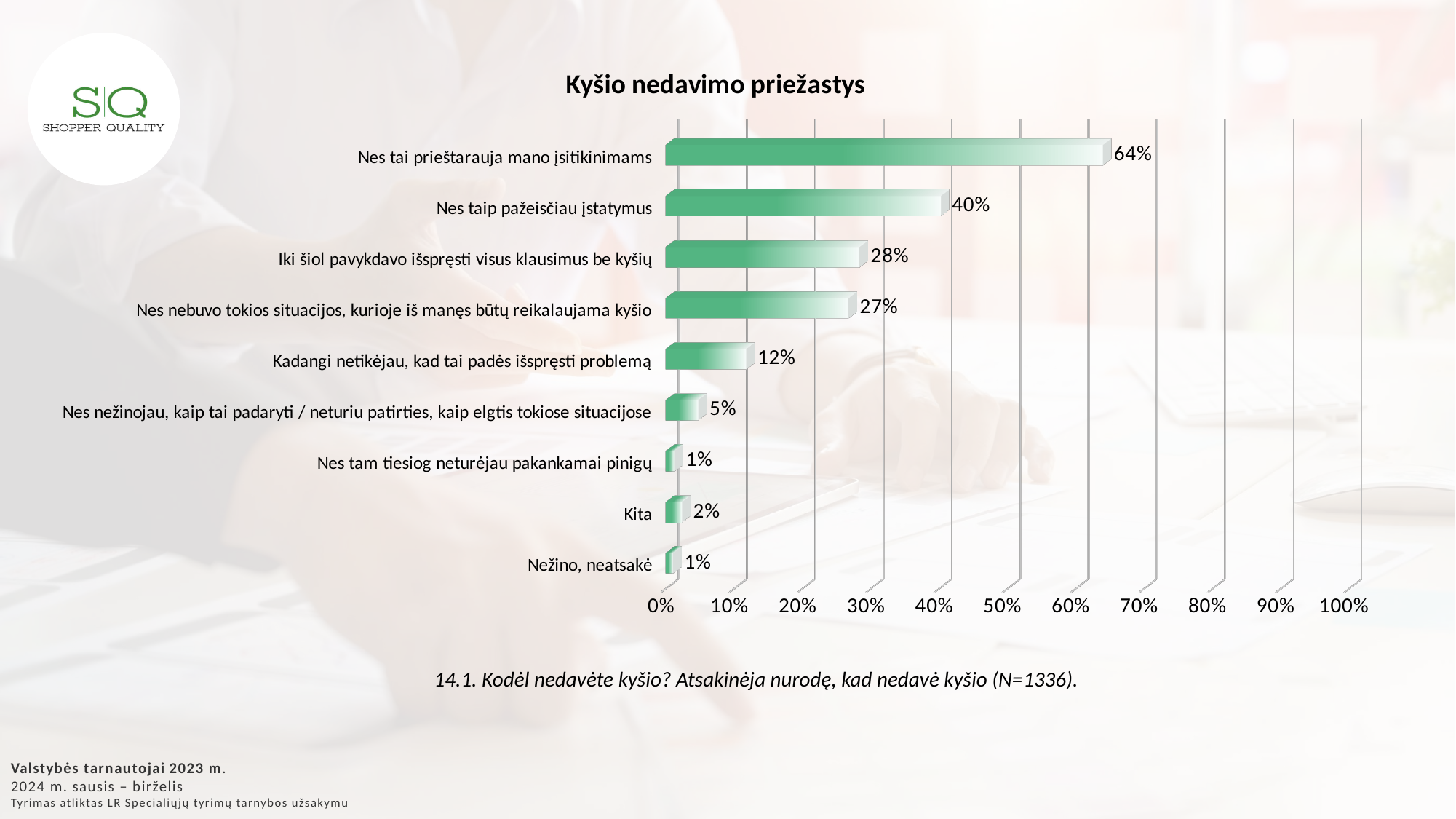
What is the value for "Nes tai prieštarauja mano įsitikinimams"? 64% Which is larger: the value for "Iki šiol pavykdavo išspręsti visus klausimus be kyšių" or the value for "Kadangi netikėjau, kad tai padės išspręsti problemą"? Iki šiol pavykdavo išspręsti visus klausimus be kyšių What is the value for "Kita"? 2% What kind of chart is shown on the slide? Bar chart What is the difference between the values for "Nes tai prieštarauja mano įsitikinimams" and "Nes taip pažeisčiau įstatymus"? 24% Which category has the highest value? Nes tai prieštarauja mano įsitikinimams How many categories are shown in the chart? 9 What is the value for "Nes taip pažeisčiau įstatymus"? 40% What is the title of the chart? Kyšio nedavimo priežastys Is the value for "Nes taip pažeisčiau įstatymus" greater or less than 30%? greater What is the value for "Kadangi netikėjau, kad tai padės išspręsti problemą"? 12% What is the difference between the values for "Iki šiol pavykdavo išspręsti visus klausimus be kyšių" and "Nes nebuvo tokios situacijos, kurioje iš manęs būtų reikalaujama kyšio"? 1%